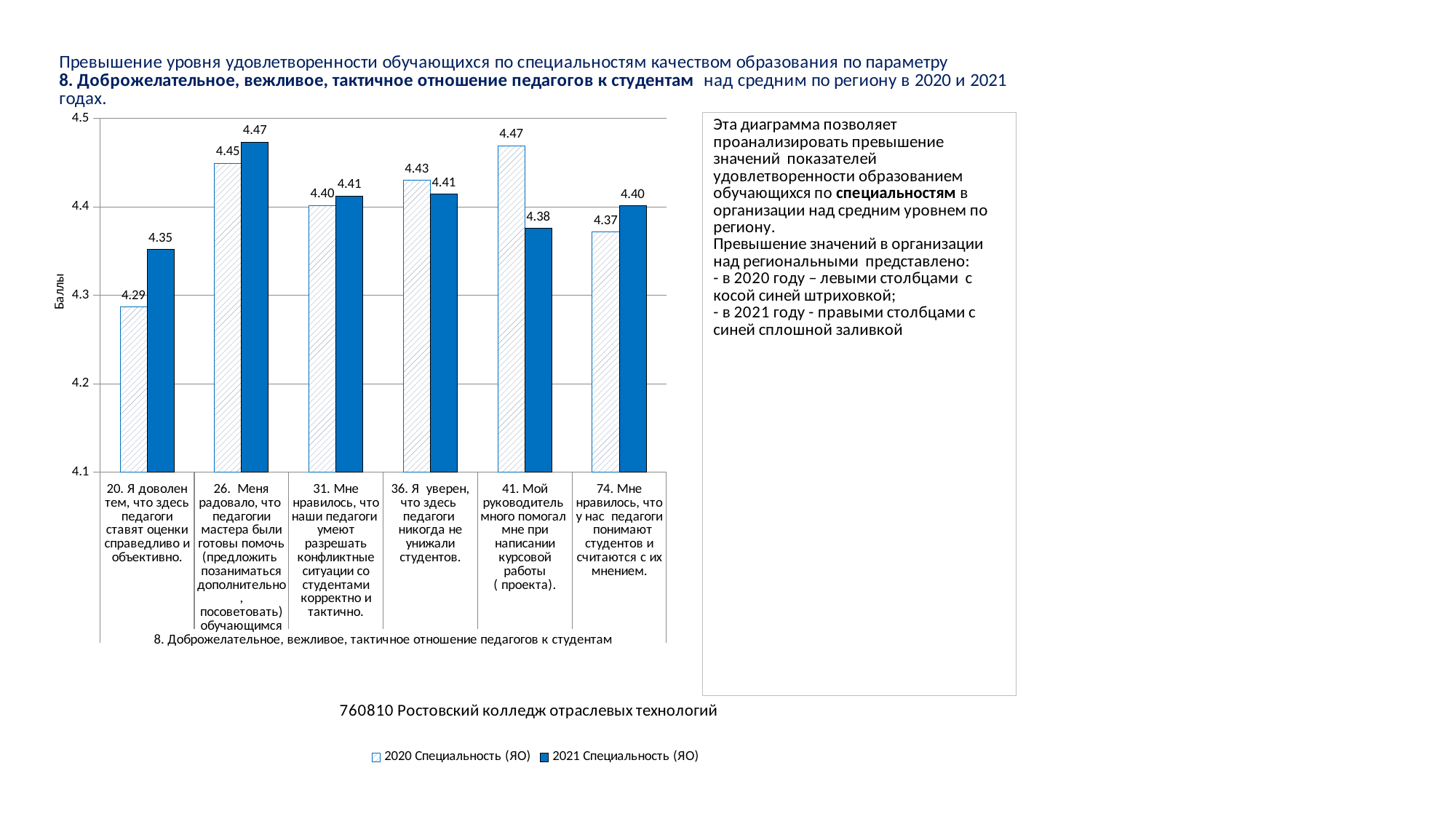
How many categories are shown on the x axis of the chart? 6 What kind of chart is shown on the slide? bar chart What is the label of the vertical axis of the chart? Баллы What is the 2020 Специальность (ЯО) value for category "74. Мне нравилось, что у нас педагоги понимают студентов и считаются с их мнением."? 4.37 What is the difference between the 2020 and 2021 values for category "41. Мой руководитель много помогал мне при написании курсовой работы (проекта)."? 0.09 What is the 2020 Специальность (ЯО) value for category "41. Мой руководитель много помогал мне при написании курсовой работы (проекта)."? 4.47 Which category has the lowest 2020 Специальность (ЯО) value? 20. Я доволен тем, что здесь педагоги ставят оценки справедливо и объективно. Is the 2021 Специальность (ЯО) value for category "20. Я доволен тем, что здесь педагоги ставят оценки справедливо и объективно." greater or less than 4.3? greater How many series does the chart legend list? 2 What is the 2021 Специальность (ЯО) value for category "20. Я доволен тем, что здесь педагоги ставят оценки справедливо и объективно."? 4.35 For category "36. Я уверен, что здесь педагоги никогда не унижали студентов.", which series has the larger value, 2020 or 2021? 2020 Специальность (ЯО) Which category has the highest 2021 Специальность (ЯО) value? 26. Меня радовало, что педагогии мастера были готовы помочь (предложить позаниматься дополнительно, посоветовать) обучающимся